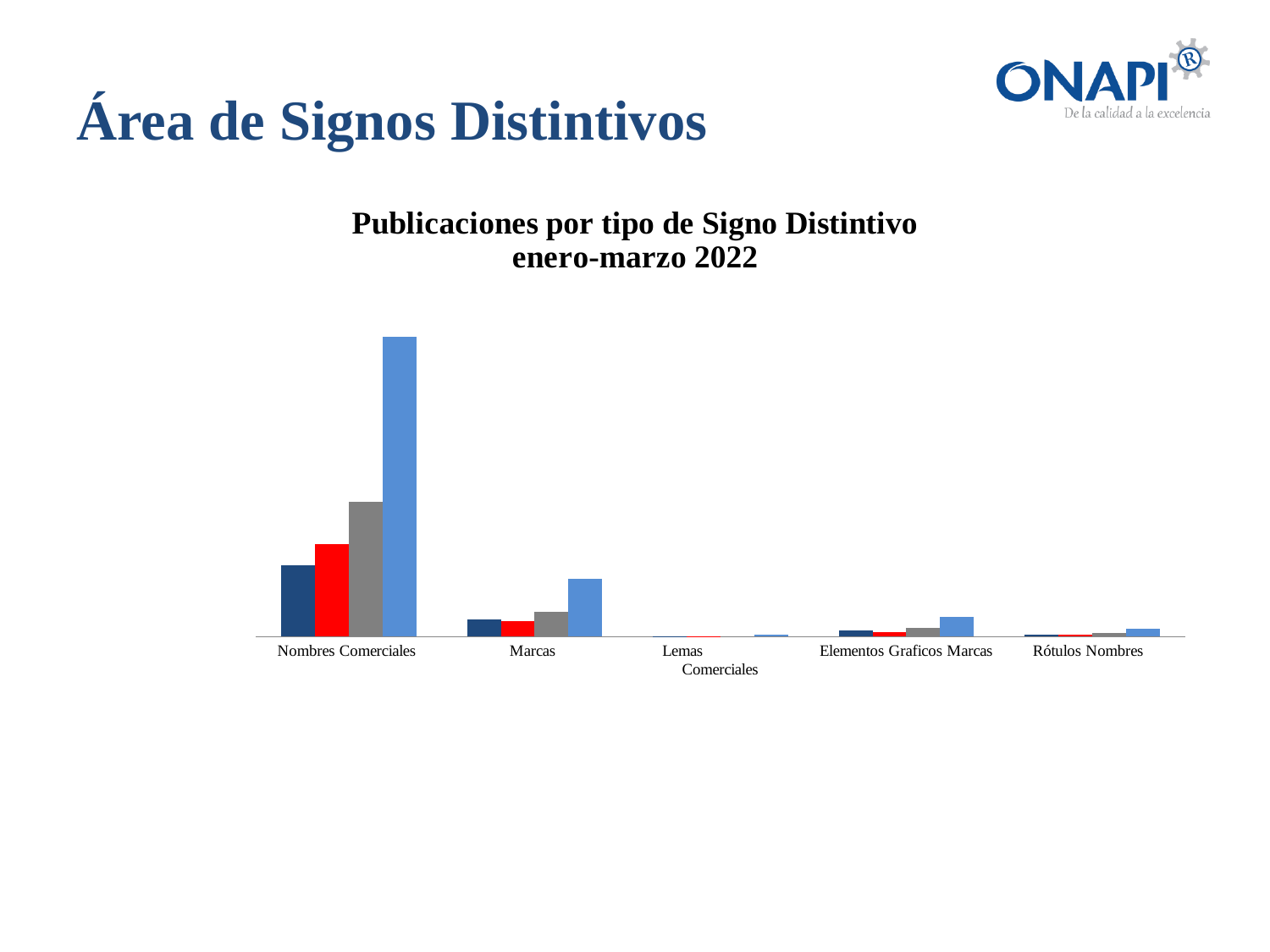
What kind of chart is shown on the slide? Bar chart How many categories are shown on the x axis of the chart? 5 Does the chart display a legend identifying the series? No Which category has taller bars, Elementos Graficos Marcas or Lemas Comerciales? Elementos Graficos Marcas Which category has the smallest bars in the chart? Lemas Comerciales How many bars are plotted for each category in the chart? 4 Which category has taller bars, Nombres Comerciales or Marcas? Nombres Comerciales What is the title of the chart? Publicaciones por tipo de Signo Distintivo enero-marzo 2022 Within the Nombres Comerciales category, which coloured bar is the tallest? Light blue Which category has the tallest bars in the chart? Nombres Comerciales Which category has taller bars, Marcas or Elementos Graficos Marcas? Marcas